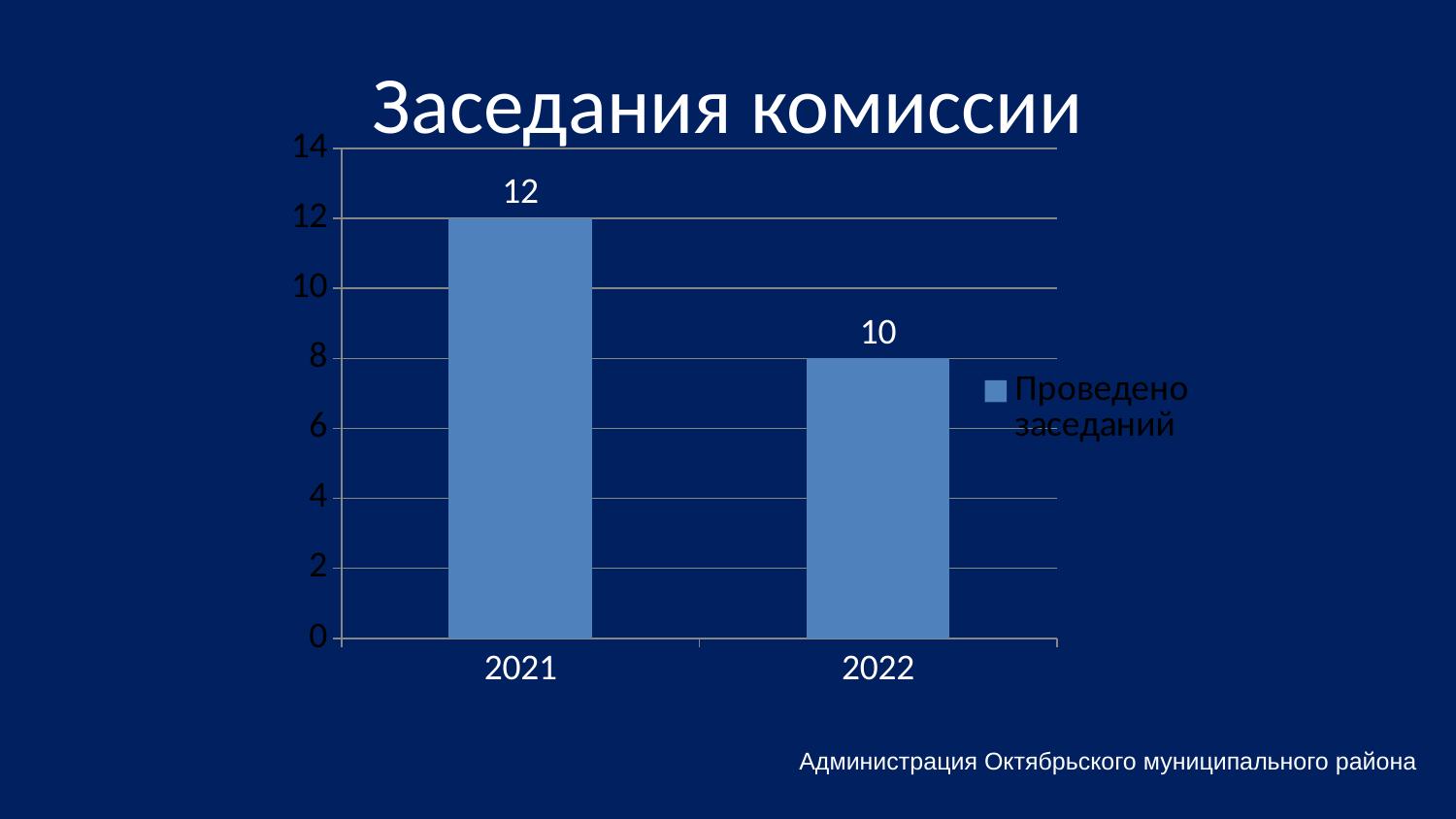
What is the value for 2021? 12 Which is larger, the value for 2021 or the value for 2022? 2021 Which year has the lowest value? 2022 What is the difference between the values for 2021 and 2022? 2 Which year has the highest value? 2021 What is the title of the chart? Заседания комиссии Do the values rise or fall from 2021 to 2022? fall What is the value for 2022? 10 What kind of chart is shown? bar chart How many series does the legend list? 1 How many categories are shown on the x axis? 2